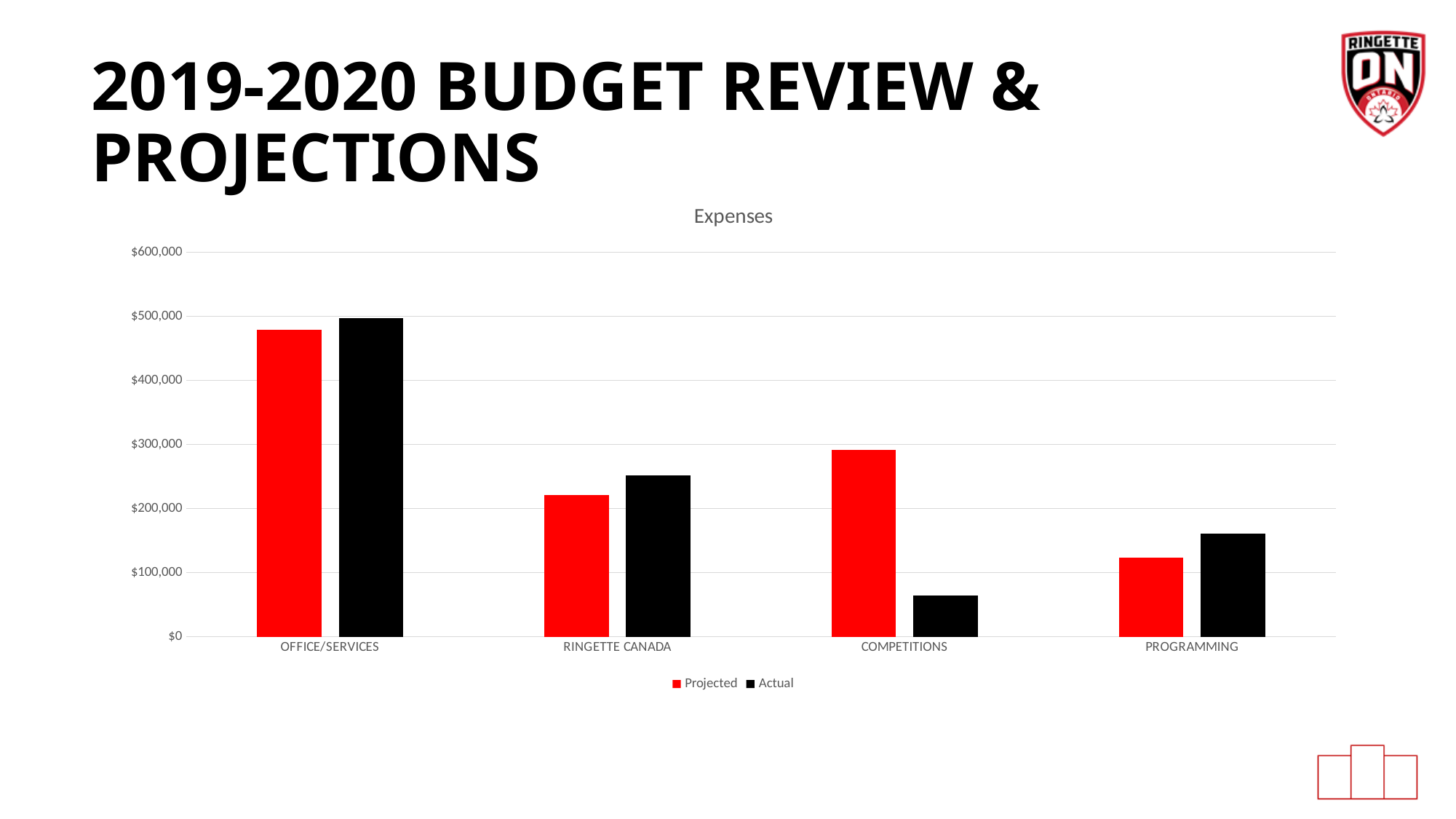
Which category has the lowest Actual expense? COMPETITIONS For PROGRAMMING, which is larger: the Projected or the Actual expense? Actual For COMPETITIONS, which is larger: the Projected or the Actual expense? Projected What is the title of the chart? Expenses What kind of chart is shown on the slide? Bar chart Which category has the highest Projected expense? OFFICE/SERVICES Which category has the highest Actual expense? OFFICE/SERVICES How many series does the legend list? 2 Is the Actual value for COMPETITIONS greater or less than $100,000? less Is the Projected value for RINGETTE CANADA greater or less than $200,000? greater Is the Actual value for OFFICE/SERVICES greater or less than $400,000? greater How many expense categories are shown on the x axis? 4